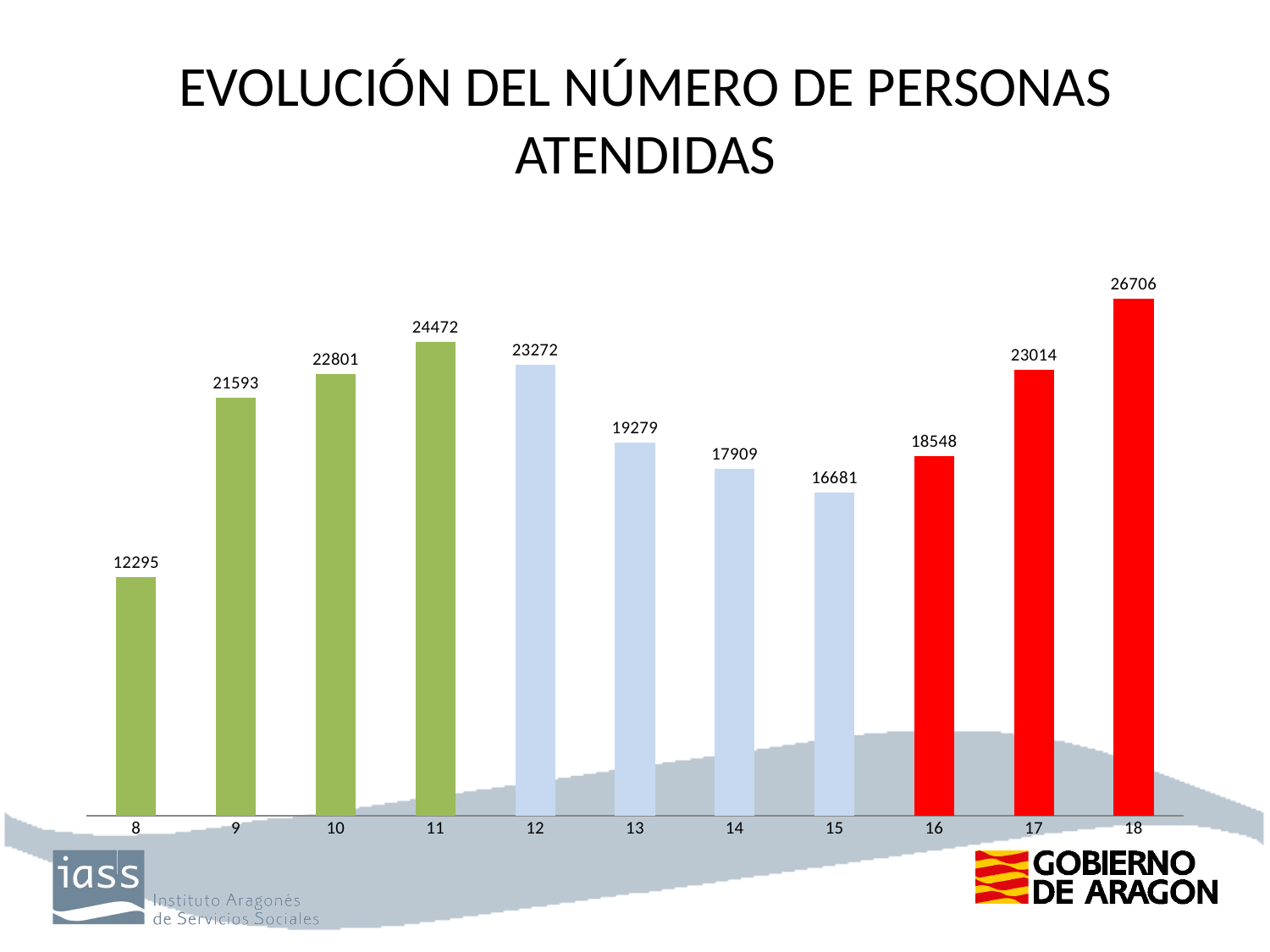
What is the value for category 15? 16681 What is the value for category 17? 23014 Which category has the highest value? 18 Do the values rise or fall from category 12 to category 15? fall What is the difference between the values for 18 and 17? 3692 What is the value for category 8? 12295 What is the difference between the values for 11 and 12? 1200 Which is larger, the value for 10 or the value for 13? 10 How many categories are shown on the x axis? 11 What is the title of the slide? EVOLUCIÓN DEL NÚMERO DE PERSONAS ATENDIDAS Which category has the lowest value? 8 What kind of chart is this? bar chart